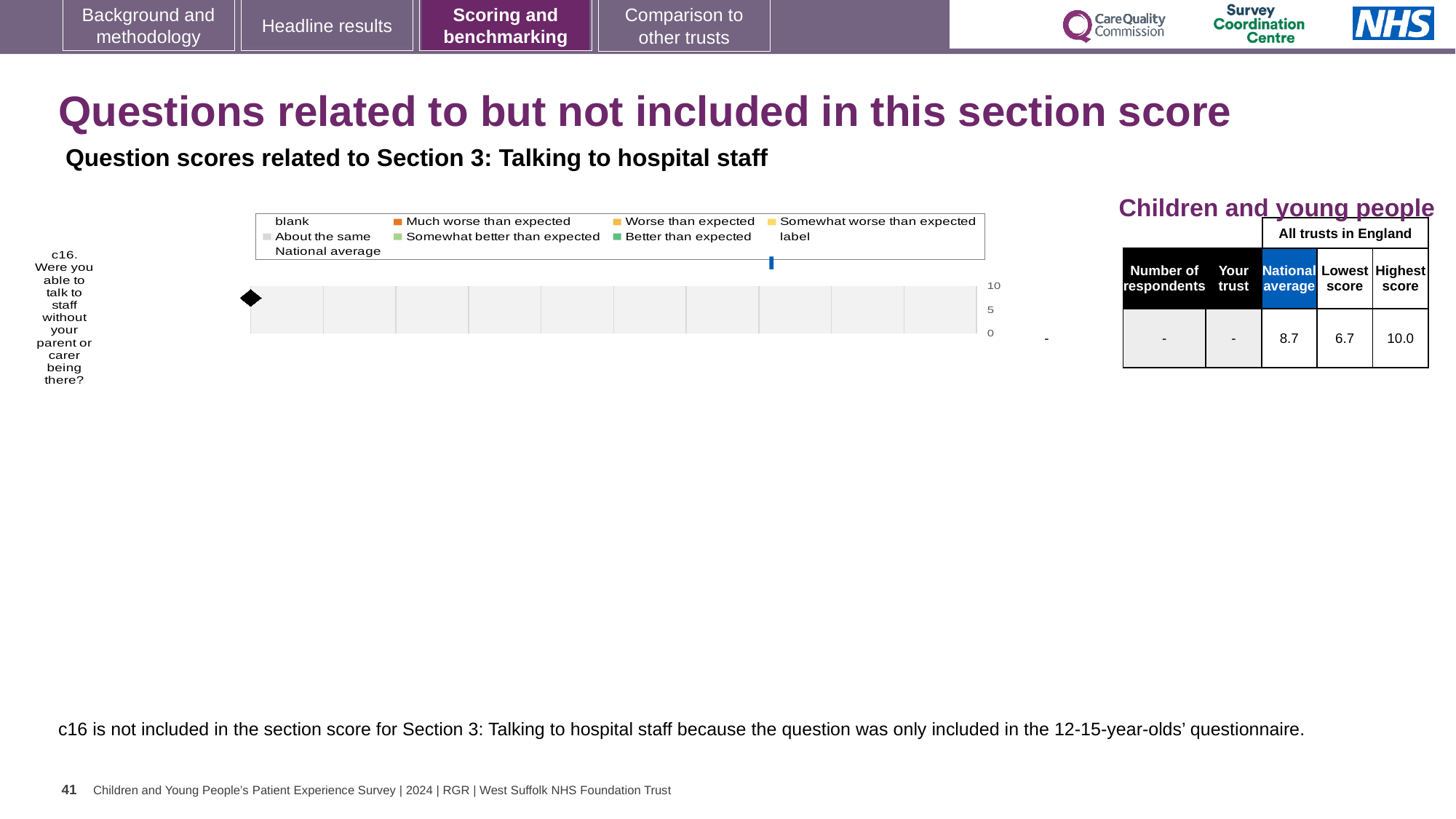
What is the highest value shown on the chart's value axis? 10 In the table to the right of the chart, what is the difference between the Highest score and the Lowest score for c16? 3.3 Which question code is the category label on the chart? c16 In the table to the right of the chart, what is the National average score for c16? 8.7 How many question categories are plotted on the chart? 1 In the table to the right of the chart, what is the Highest score across all trusts in England for c16? 10.0 In the table to the right of the chart, what is the Lowest score across all trusts in England for c16? 6.7 In the table to the right of the chart, is the National average for c16 greater or less than the Lowest score? greater